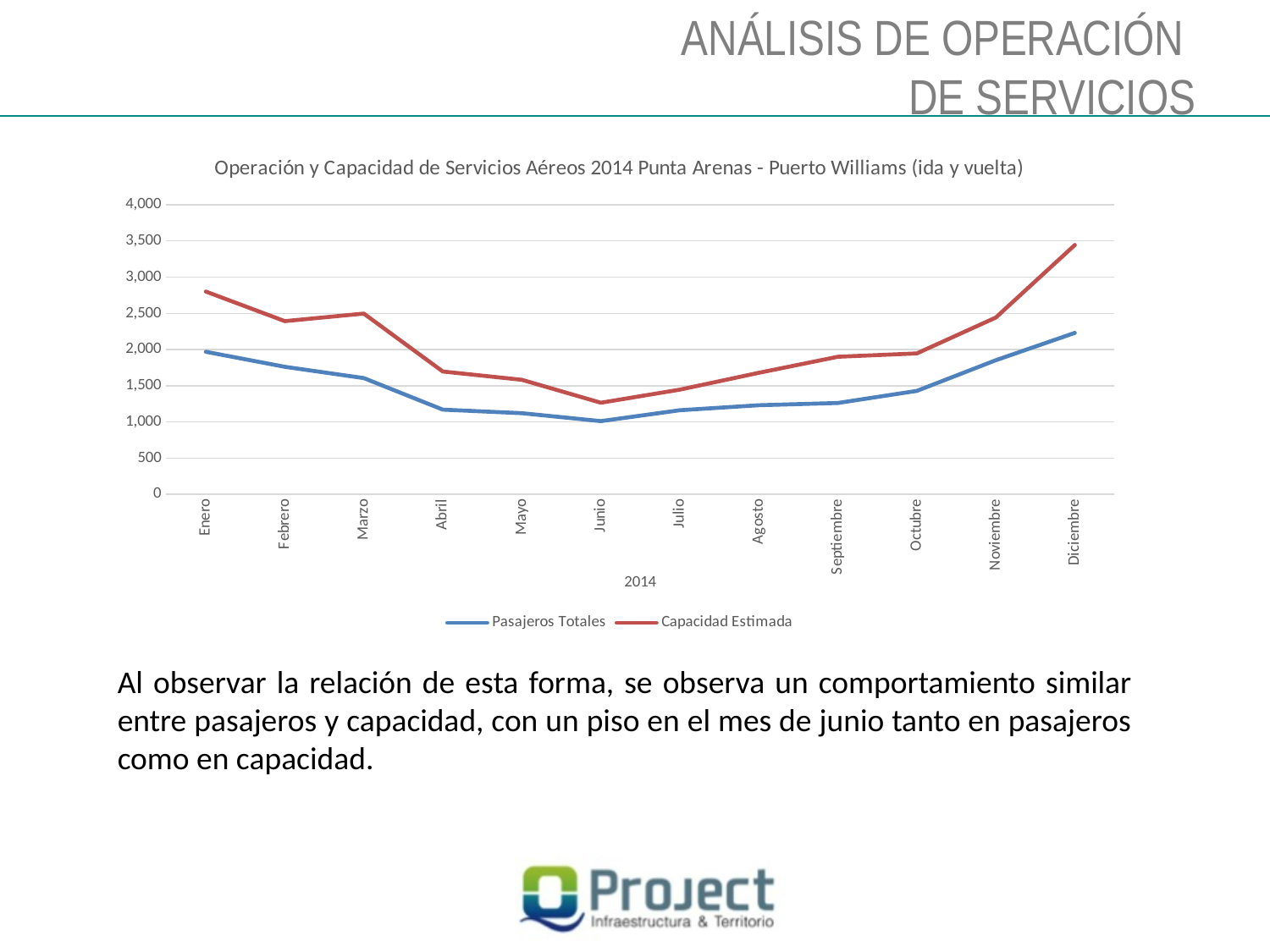
Does Pasajeros Totales rise or fall from Junio to Diciembre? Rise How many months are plotted along the x axis? 12 Is the value of Capacidad Estimada in Enero greater or less than 2,500? greater Is the value of Capacidad Estimada in Diciembre greater or less than 3,000? greater In which month is Capacidad Estimada lowest? Junio How many series does the legend list? 2 Which is larger in Diciembre, Pasajeros Totales or Capacidad Estimada? Capacidad Estimada Is the value of Pasajeros Totales in Junio greater or less than 1,500? less In which month is Pasajeros Totales lowest? Junio In which month is Capacidad Estimada highest? Diciembre What kind of chart is shown on the slide? Line chart What are the two series named in the legend? Pasajeros Totales and Capacidad Estimada